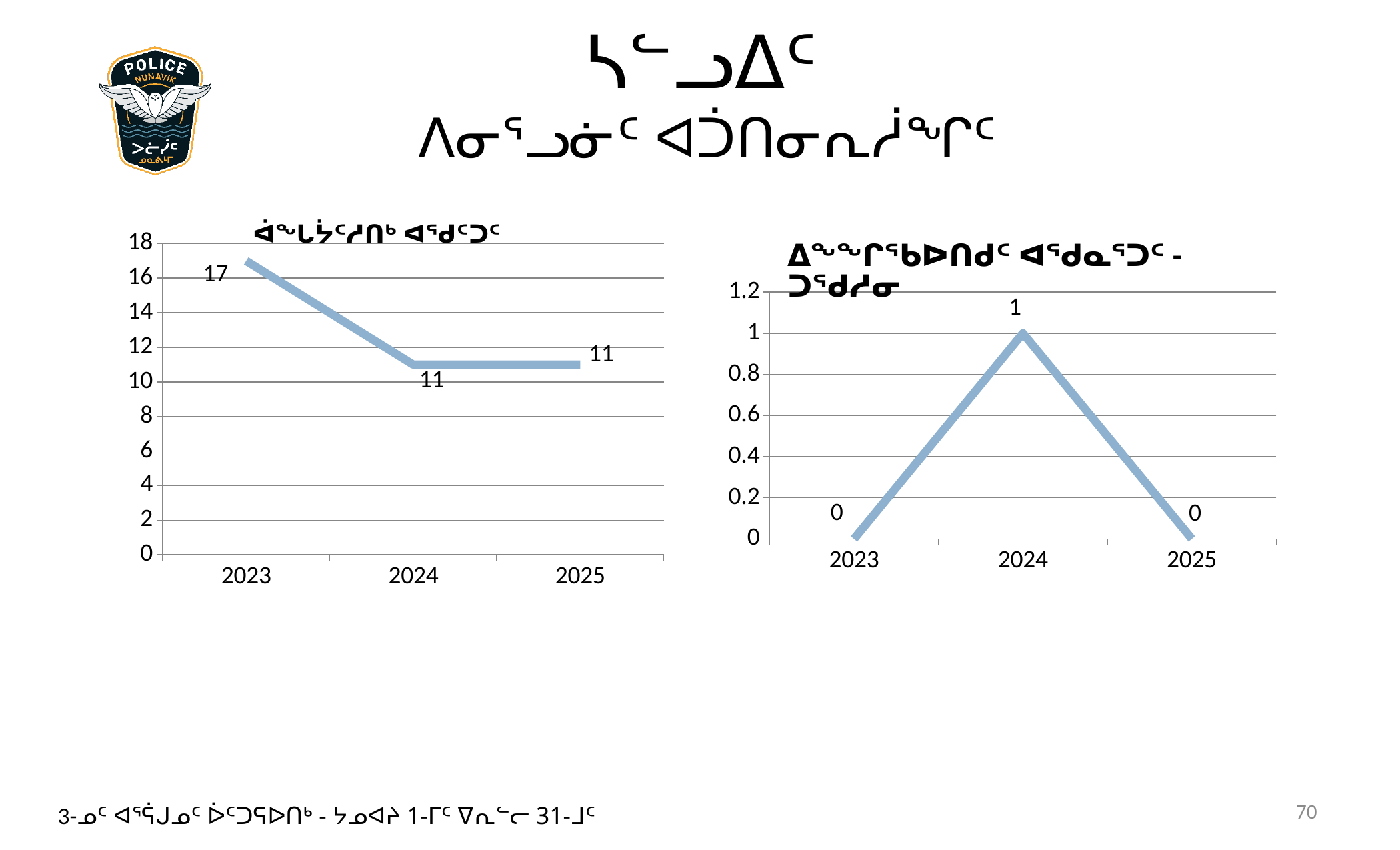
In the left chart, what is the difference between the values for 2023 and 2024? 6 What kind of chart is the left chart? Line chart In the left chart, which year has the highest value? 2023 In the left chart, what is the value for 2024? 11 In the left chart, do the values rise or fall from 2023 to 2024? Fall In the left chart, is the value for 2023 greater or less than 16? greater In the left chart, what is the value for 2023? 17 In the right chart, what is the value for 2025? 0 In the right chart, which year has the highest value? 2024 In the left chart, how many years are plotted on the x axis? 3 In the right chart, what is the value for 2024? 1 In the left chart, what is the value for 2025? 11